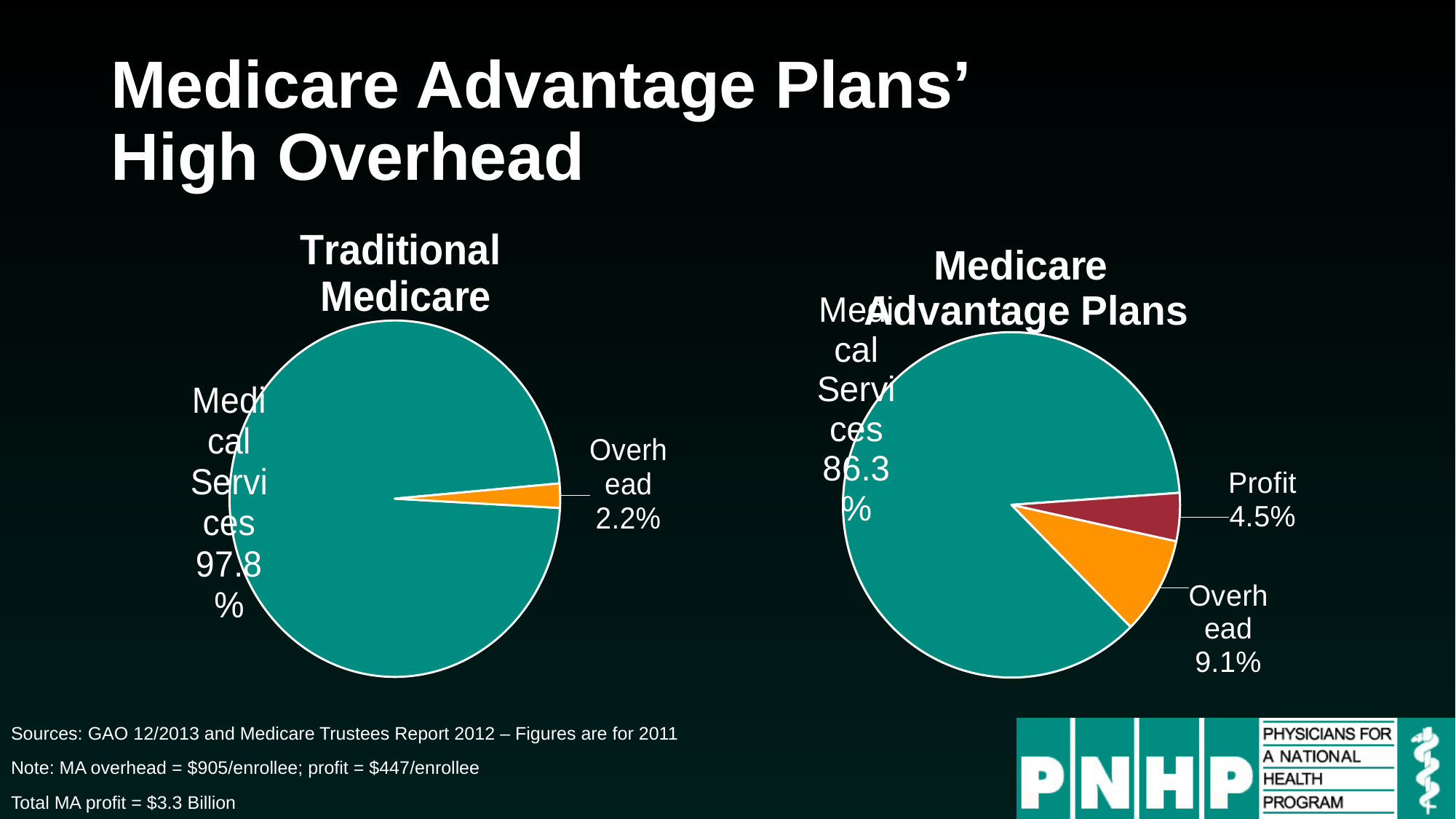
In the Medicare Advantage Plans chart, which slice is the smallest? Profit In the Medicare Advantage Plans chart, what share is Profit? 4.5% In the Medicare Advantage Plans chart, which slice is the largest? Medical Services How many slices does the Medicare Advantage Plans chart have? 3 In the Traditional Medicare chart, what share is Medical Services? 97.8% What type of chart is used for Traditional Medicare? Pie chart In the Medicare Advantage Plans chart, what share is Medical Services? 86.3% What is the difference between the Overhead share in the Medicare Advantage Plans chart and the Overhead share in the Traditional Medicare chart? 6.9% In the Traditional Medicare chart, what share is Overhead? 2.2% In the Medicare Advantage Plans chart, what share is Overhead? 9.1% Which chart has the larger Overhead share, Traditional Medicare or Medicare Advantage Plans? Medicare Advantage Plans In the Medicare Advantage Plans chart, what is the difference between the Overhead and Profit shares? 4.6%